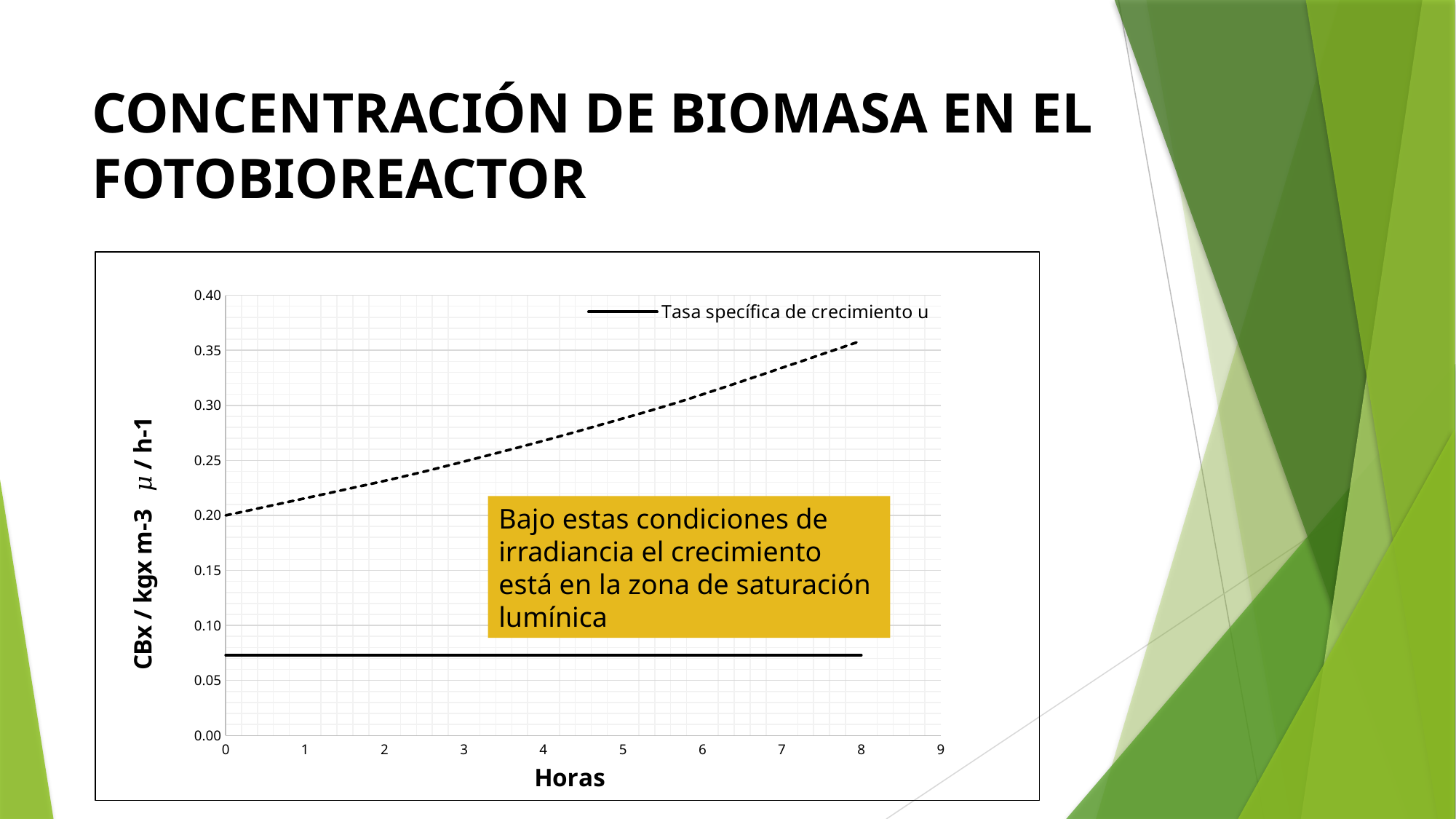
What kind of chart is shown on the slide? line chart Is the value of the dashed line at hour 8 greater or less than 0.30? greater Is the value of the dashed line at hour 6 greater or less than 0.25? greater What is the legend entry shown in the chart? Tasa specífica de crecimiento u Is the value of the solid horizontal line greater or less than 0.10? less At hour 2, which line has the larger value, the dashed line or the solid line? the dashed line Does the dashed line rise or fall as the hours increase from 0 to 8? rise What is the title of the x axis of the chart? Horas Does the solid line rise, fall or stay flat across the hours? stay flat How many entries does the chart legend list? 1